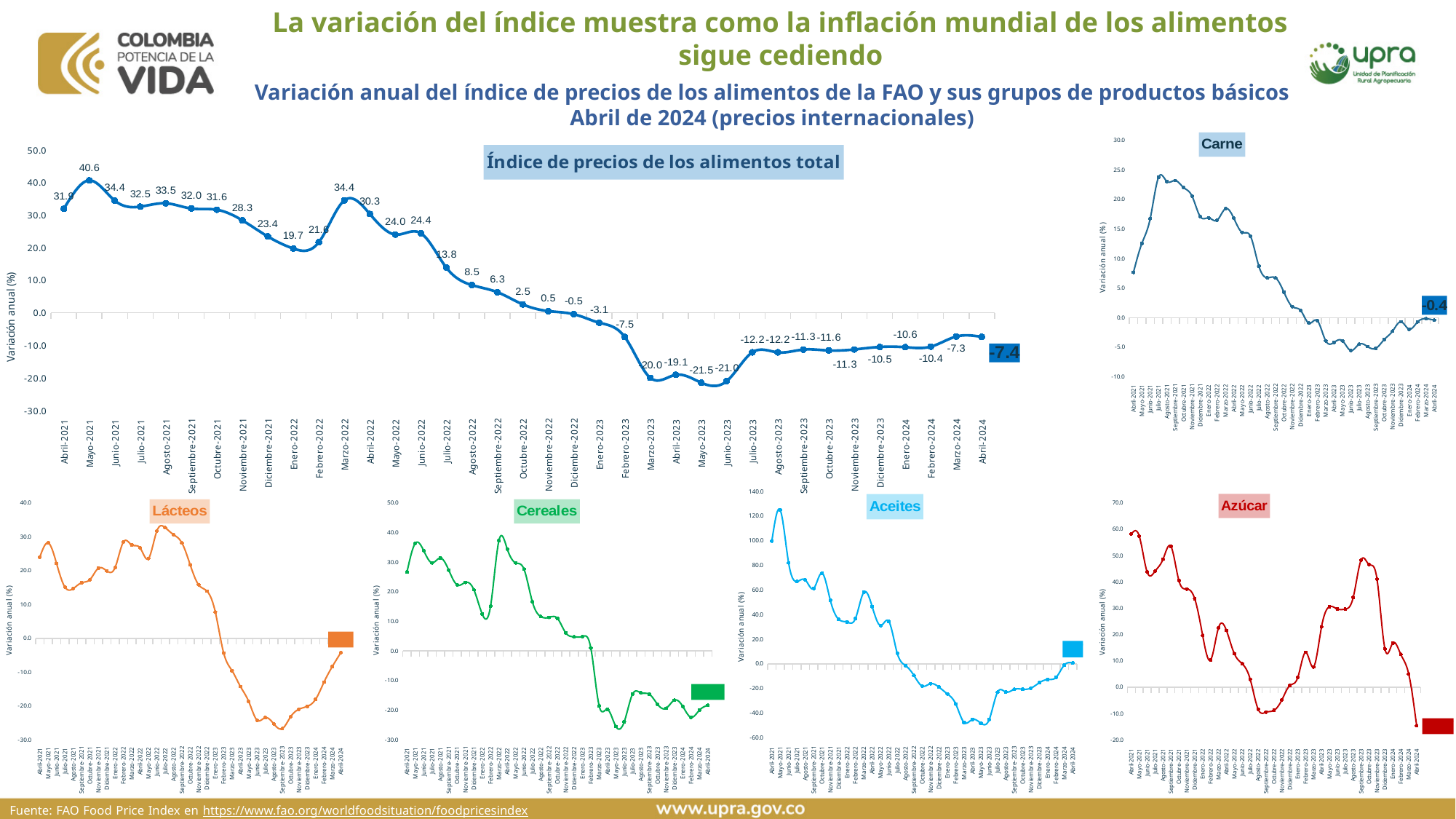
In the 'Índice de precios de los alimentos total' chart, what is the value for Mayo-2021? 40.6 In the 'Índice de precios de los alimentos total' chart, which is larger, the value for Marzo-2022 or Abril-2022? Marzo-2022 What kind of chart is the 'Índice de precios de los alimentos total' chart? Line chart In the 'Índice de precios de los alimentos total' chart, which month has the highest value? Mayo-2021 In the 'Azúcar' chart, is the value for Abril-2021 greater or less than 50? greater In the 'Índice de precios de los alimentos total' chart, do the values rise or fall from Mayo-2021 to Enero-2022? Fall In the 'Índice de precios de los alimentos total' chart, what is the value for Abril-2024? -7.4 In the 'Índice de precios de los alimentos total' chart, what is the difference between the values for Mayo-2021 and Abril-2021? 8.7 In the 'Carne' chart, what is the value for Abril-2024? -0.4 In the 'Índice de precios de los alimentos total' chart, which month has the lowest value? Mayo-2023 In the 'Aceites' chart, is the value for Abril-2021 greater or less than 80? greater In the 'Índice de precios de los alimentos total' chart, what is the difference between the values for Julio-2022 and Agosto-2022? 5.3